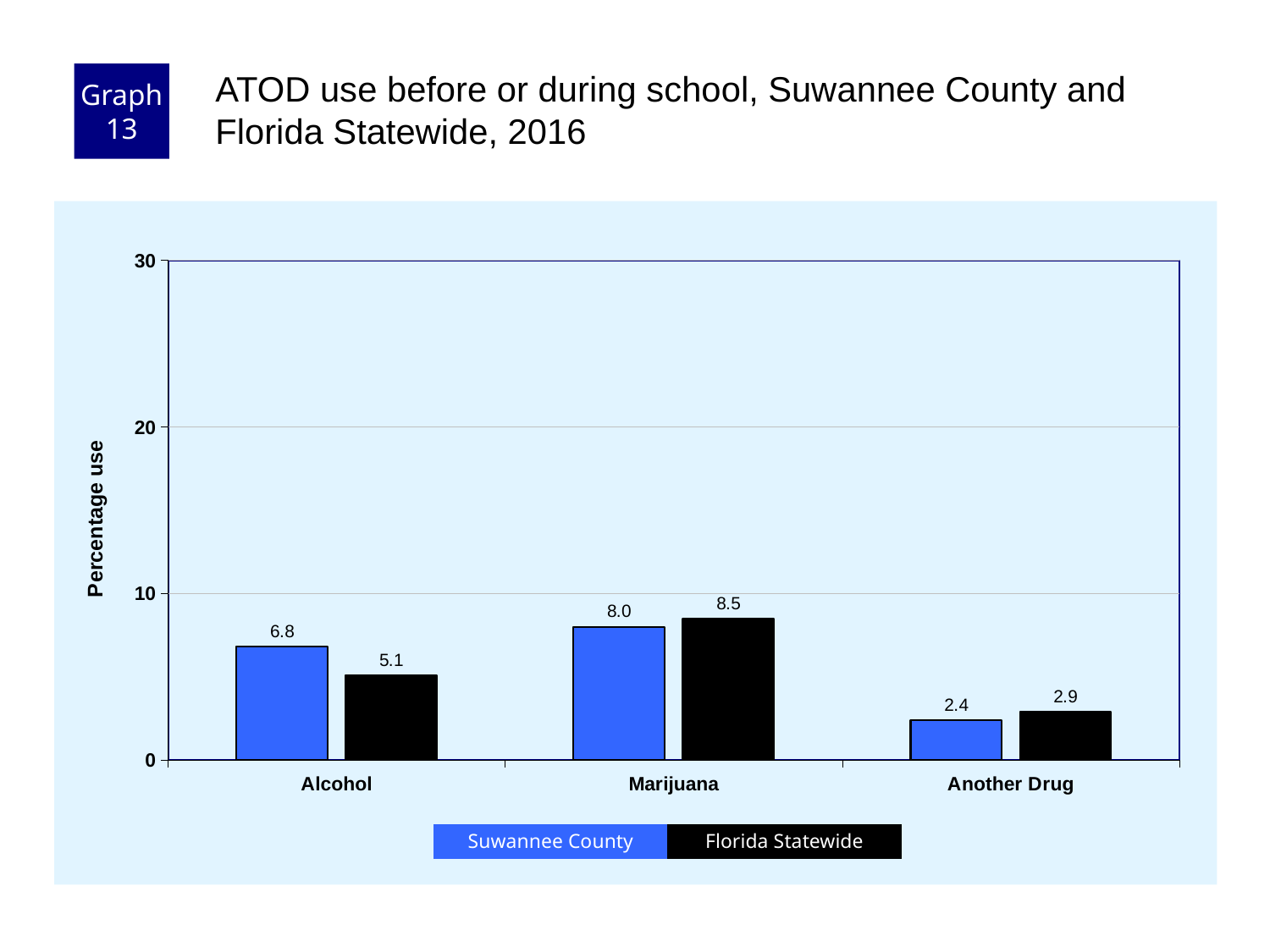
Which category has the lowest Suwannee County value? Another Drug What is the Suwannee County value for Another Drug? 2.4 What is the difference between the Suwannee County and Florida Statewide values for Alcohol? 1.7 Which is larger for Marijuana, Suwannee County or Florida Statewide? Florida Statewide Which category has the highest Florida Statewide value? Marijuana Is the Florida Statewide value for Alcohol greater or less than 10? less What is the Florida Statewide value for Marijuana? 8.5 How many categories are shown on the x axis? 3 What is the Suwannee County value for Alcohol? 6.8 What is the label of the y axis? Percentage use What kind of chart is shown on the slide? bar chart How many series does the legend list? 2